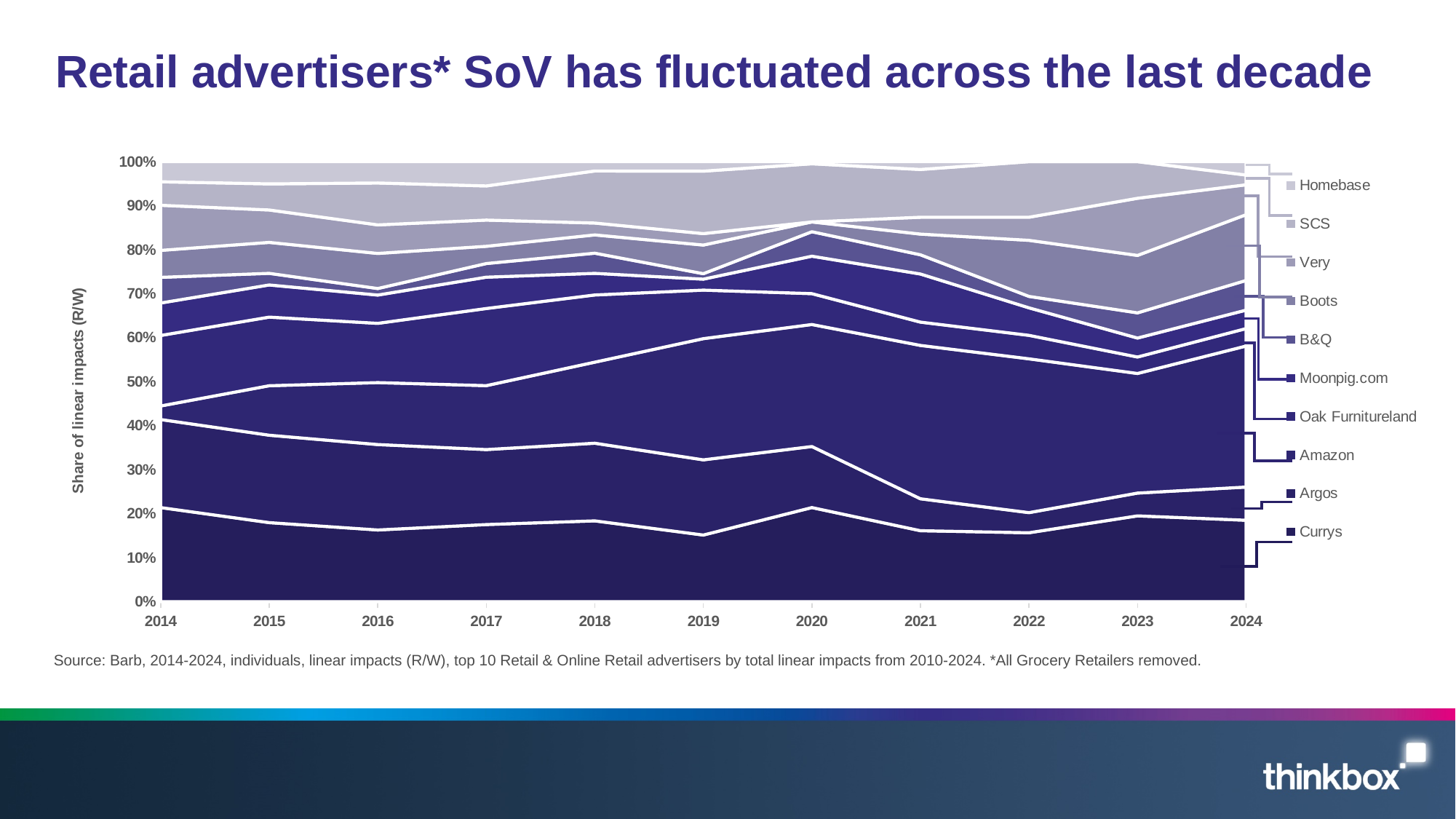
What is the label of the y axis? Share of linear impacts (R/W) How many advertisers does the legend list? 10 Does the share for Currys rise or fall from 2014 to 2019? Fall Which is larger, the share for Currys in 2014 or in 2019? 2014 What is the last year shown on the x axis? 2024 What is the first year shown on the x axis? 2014 Which advertiser forms the bottom band of the stacked area chart? Currys Is the share for Currys in 2022 greater or less than 20%? less How many years are shown along the x axis? 11 What kind of chart is shown on the slide? Stacked area chart Which is larger, the share for Currys in 2020 or in 2021? 2020 Is the share for Currys in 2019 greater or less than 20%? less